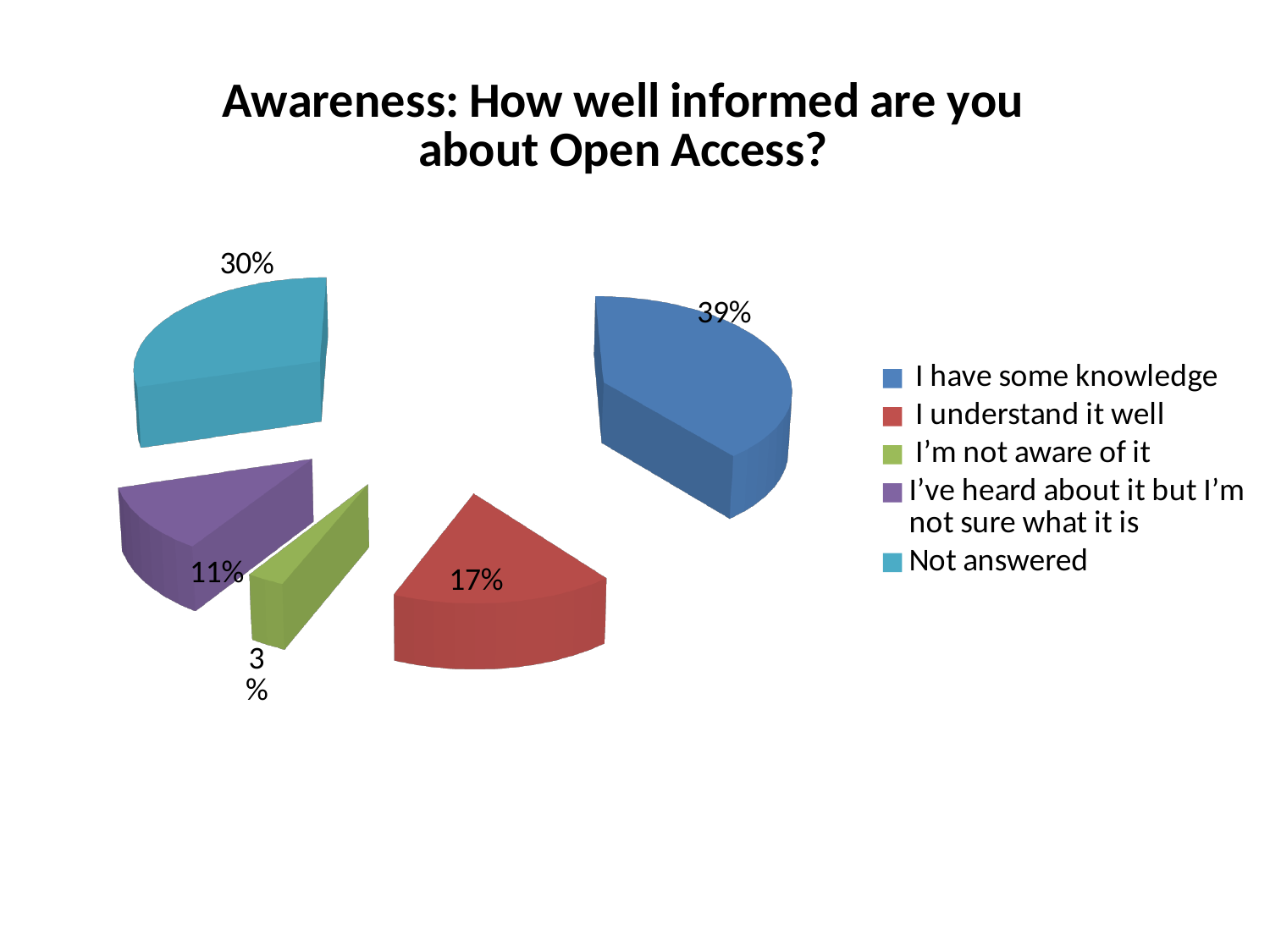
What is the difference in percentage points between "I have some knowledge" and "Not answered"? 9% What share of the pie is labelled for "Not answered"? 30% How many categories does the legend list? 5 What share of the pie is labelled for "I understand it well"? 17% Which category has the largest slice of the pie? I have some knowledge What kind of chart is shown on the slide? Pie chart What is the title of the chart? Awareness: How well informed are you about Open Access? Which is larger: the slice for "I understand it well" or the slice for "I've heard about it but I'm not sure what it is"? I understand it well What share of the pie is labelled for "I've heard about it but I'm not sure what it is"? 11% Which category has the smallest slice of the pie? I'm not aware of it